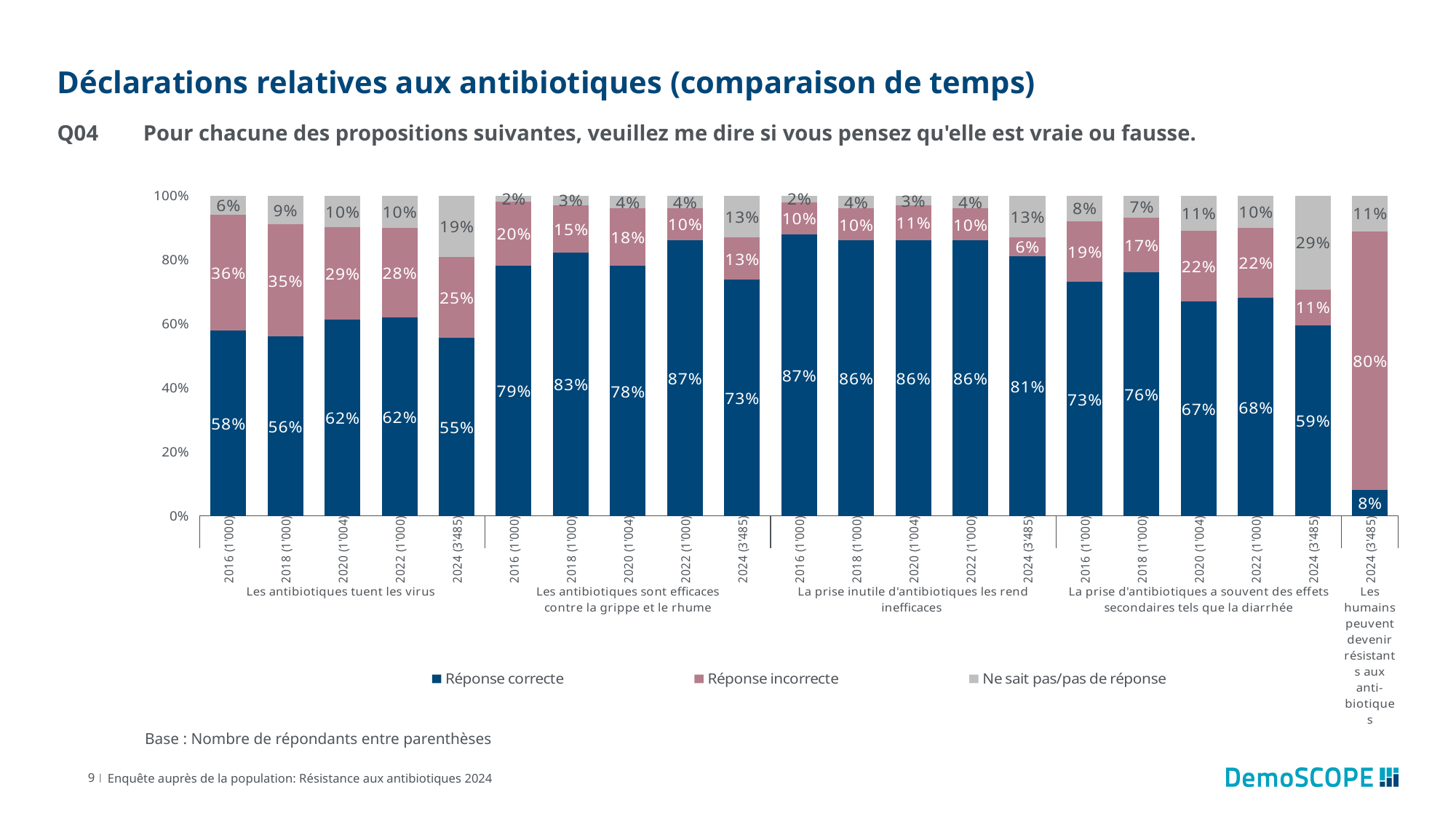
What is the 'Réponse incorrecte' value for 2024 (3'485) under 'Les humains peuvent devenir résistants aux antibiotiques'? 80% What is the 'Réponse correcte' value for 2024 (3'485) under 'Les antibiotiques tuent les virus'? 55% What is the 'Ne sait pas/pas de réponse' value for 2024 (3'485) under 'La prise d'antibiotiques a souvent des effets secondaires tels que la diarrhée'? 29% How does the 'Réponse correcte' value change from 2016 (1'000) to 2024 (3'485) under 'La prise d'antibiotiques a souvent des effets secondaires tels que la diarrhée'? it falls Which legend entry is shown in grey? Ne sait pas/pas de réponse Under 'La prise d'antibiotiques a souvent des effets secondaires tels que la diarrhée', which year has the lowest 'Réponse correcte' value? 2024 (3'485) What is the difference between the 'Réponse correcte' values for 2016 (1'000) and 2024 (3'485) under 'La prise inutile d'antibiotiques les rend inefficaces'? 6% What kind of chart is shown on the slide? stacked bar chart Under 'Les antibiotiques sont efficaces contre la grippe et le rhume', which year has the highest 'Réponse correcte' value? 2022 (1'000) Under 'Les antibiotiques tuent les virus', is the 'Réponse incorrecte' value larger for 2016 (1'000) or for 2024 (3'485)? 2016 (1'000) How many bars are shown under 'Les humains peuvent devenir résistants aux antibiotiques'? 1 How many series does the legend list? 3